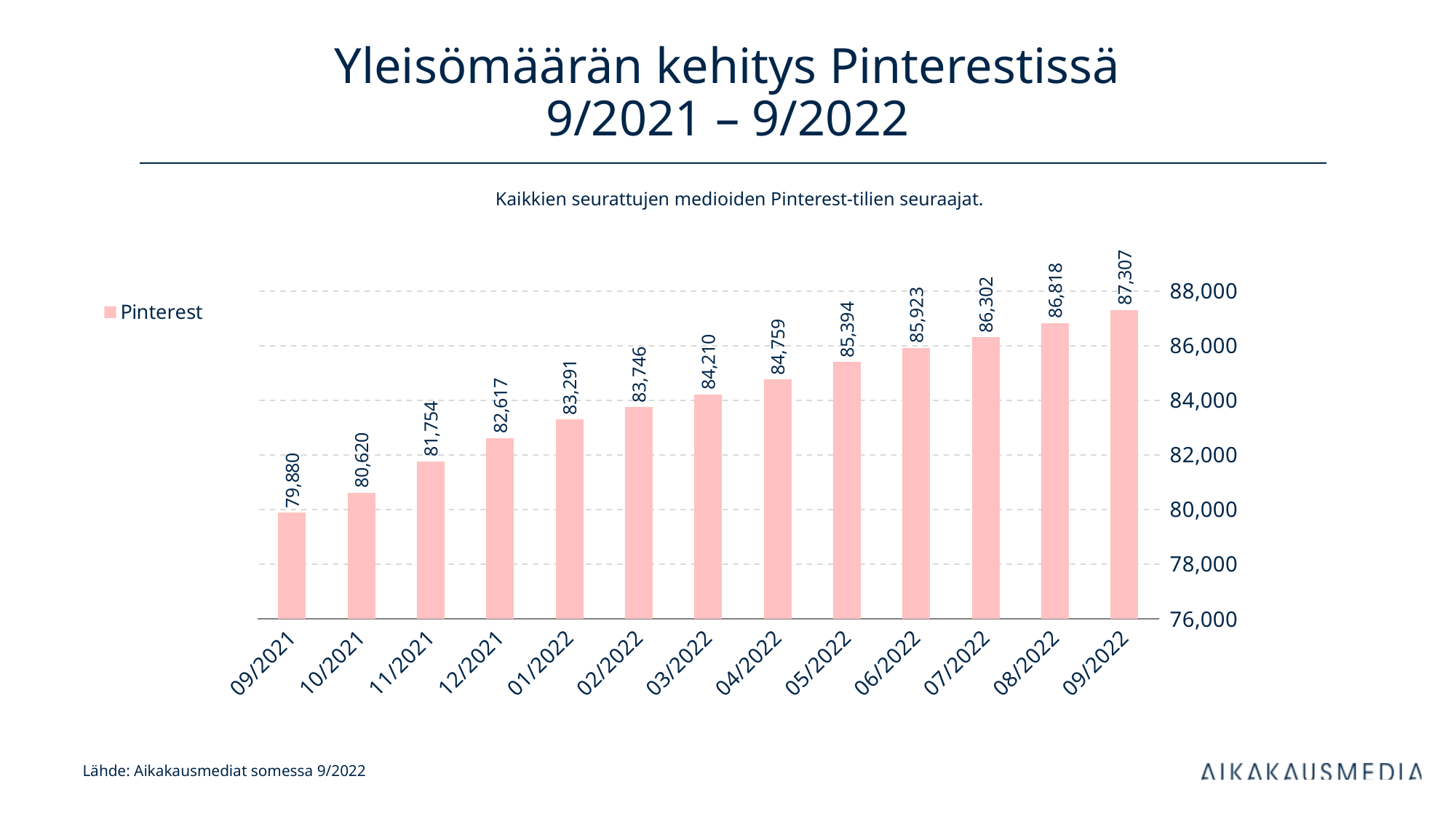
Is the value for 11/2021 greater or less than 82,000? less Which is larger, the value for 05/2022 or the value for 06/2022? 06/2022 What is the value for 09/2021? 79,880 What is the difference between the values for 09/2022 and 09/2021? 7,427 What is the difference between the values for 01/2022 and 12/2021? 674 Which month has the lowest value? 09/2021 Do the values rise or fall from 09/2021 to 09/2022? rise What is the value for 03/2022? 84,210 What kind of chart is shown on the slide? bar chart What is the value for 09/2022? 87,307 Which month has the highest value? 09/2022 How many months are shown on the x axis? 13